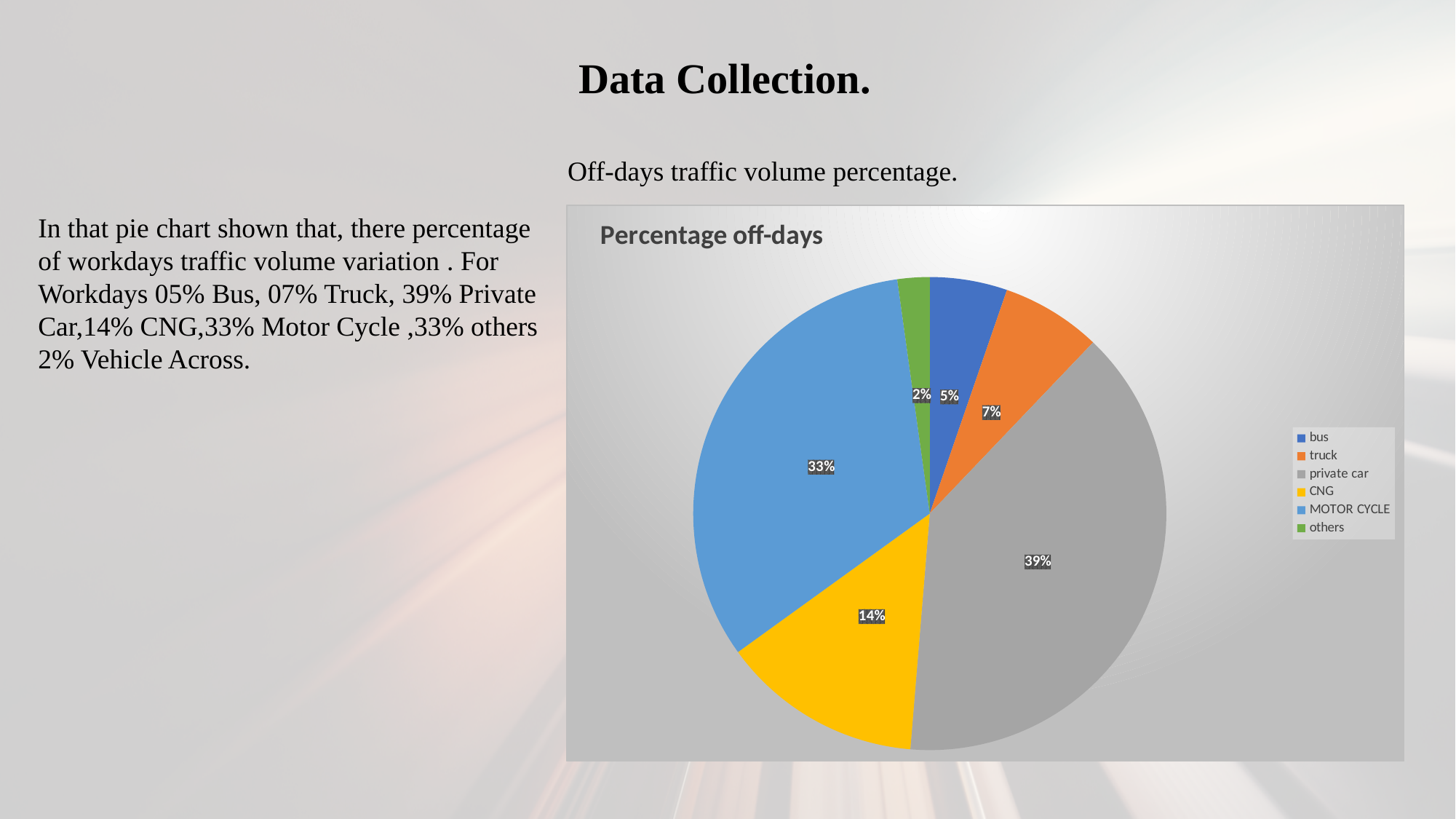
Which category has the largest slice of the pie? private car What percentage does the CNG slice show? 14% What type of chart is shown on the slide? pie chart Which is larger, the CNG slice or the truck slice? CNG What percentage does the MOTOR CYCLE slice show? 33% What percentage does the private car slice show? 39% What is the title of the chart? Percentage off-days How many categories does the legend list? 6 What percentage does the bus slice show? 5% What is the difference between the private car and MOTOR CYCLE percentages? 6% What percentage does the truck slice show? 7% Which category has the smallest slice of the pie? others